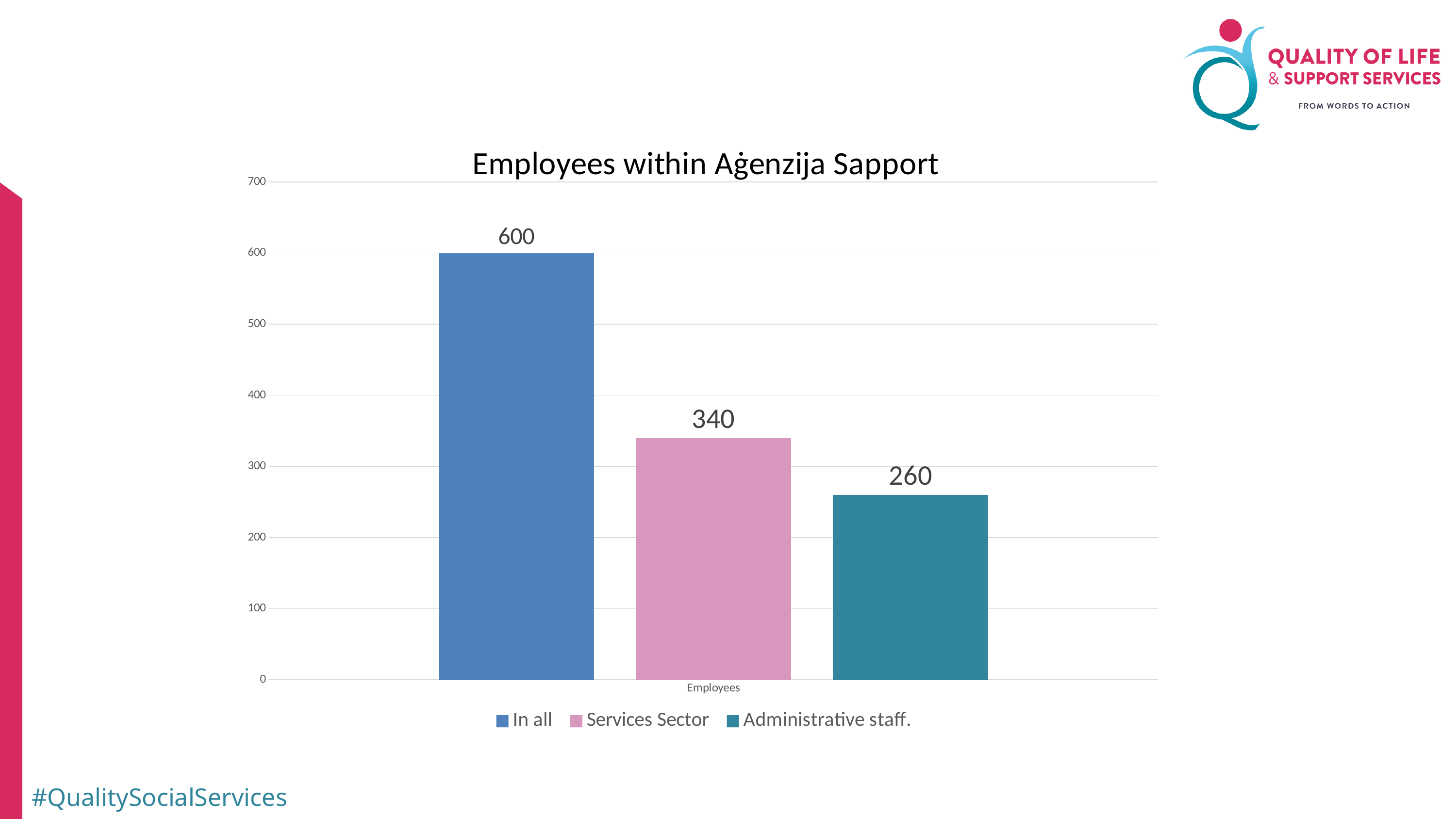
Which series has the lowest value? Administrative staff. What is the title of the chart? Employees within Aġenzija Sapport What is the value for Administrative staff.? 260 Which series has the highest value? In all Is the value for Administrative staff. greater or less than 300? less What kind of chart is shown on the slide? bar chart What is the difference between the In all value and the Services Sector value? 260 Which is larger, the value for Services Sector or the value for Administrative staff.? Services Sector What is the difference between the Services Sector value and the Administrative staff. value? 80 What is the value for In all? 600 What is the value for Services Sector? 340 How many series does the legend list? 3